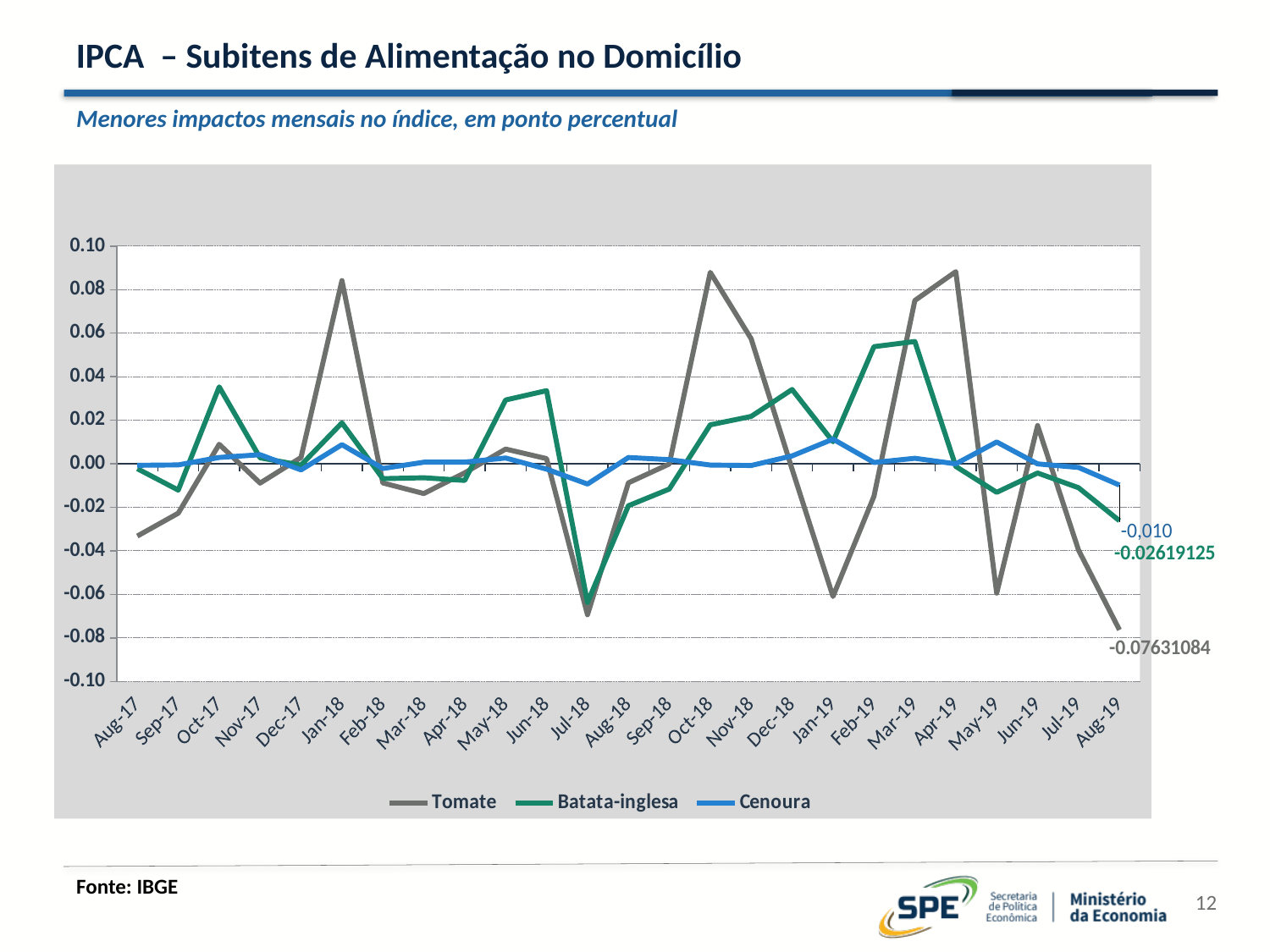
What kind of chart is shown on the slide? line chart What is the difference between the Batata-inglesa and Tomate values in Aug-19? 0.05011959 What is the value for Cenoura in Aug-19? -0,010 What is the value for Tomate in Aug-19? -0.07631084 How many months are shown on the x axis? 25 Is the value for Batata-inglesa in Mar-19 greater or less than 0.04? greater Which series is drawn in blue? Cenoura How many series does the legend list? 3 What is the value for Batata-inglesa in Aug-19? -0.02619125 In Aug-19, which series has the higher value, Tomate or Batata-inglesa? Batata-inglesa Is the value for Tomate in Jan-18 greater or less than 0.06? greater Is the value for Tomate in Jul-18 greater or less than -0.04? less